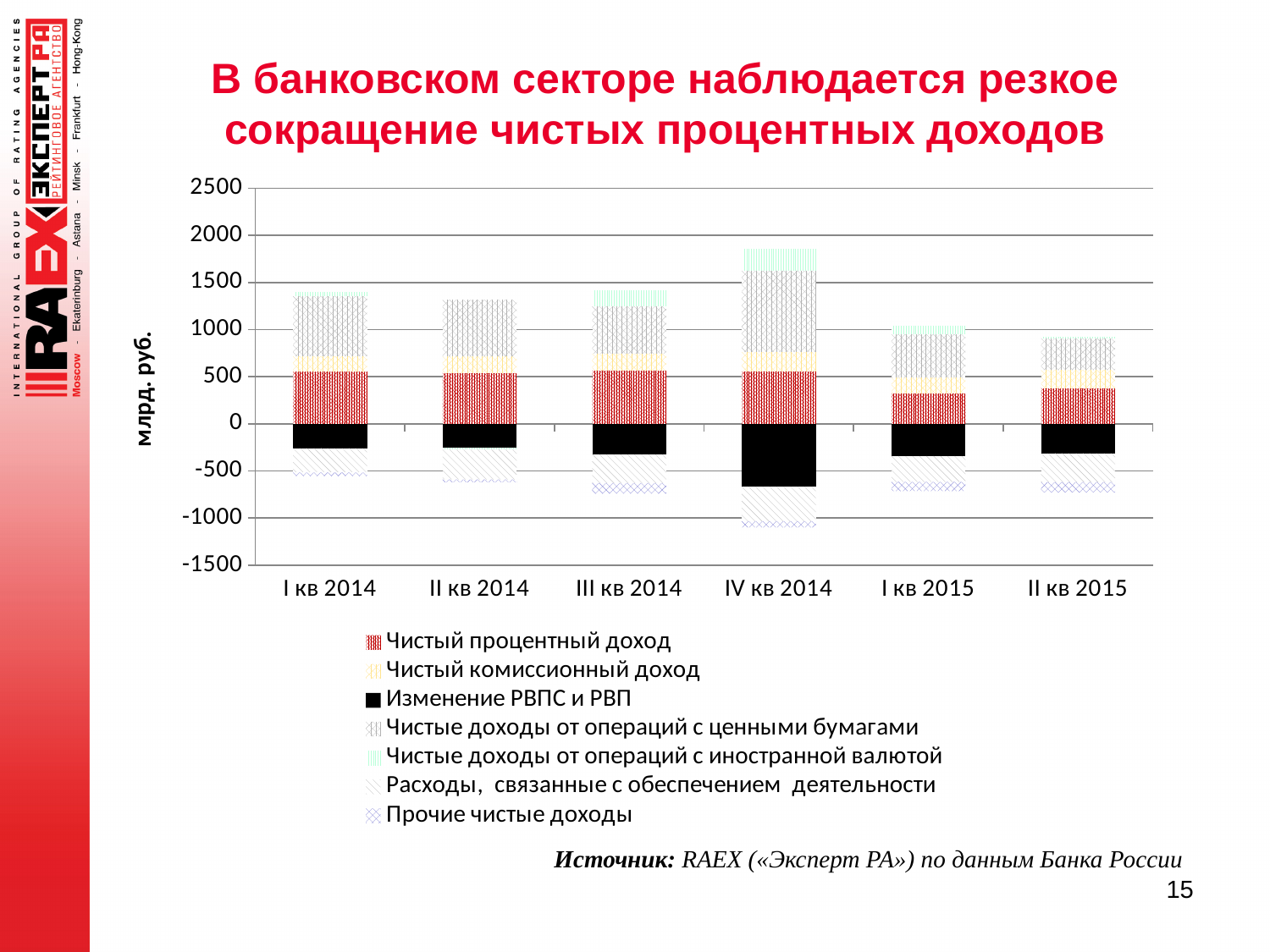
Is the total positive stack for II кв 2015 greater or less than 1000? less What kind of chart is shown on the slide? Stacked bar chart Is the total positive stack for IV кв 2014 greater or less than 1500? greater How many series does the chart legend list? 7 Which quarter has the largest negative value for 'Изменение РВПС и РВП'? IV кв 2014 Which quarter has the tallest positive stacked bar? IV кв 2014 Is the value of 'Чистый процентный доход' for II кв 2015 greater or less than 500? less What is the unit shown on the vertical axis of the chart? млрд. руб. How many quarters (categories) are shown on the x axis of the chart? 6 What is the title of the slide containing the chart? В банковском секторе наблюдается резкое сокращение чистых процентных доходов Which is larger, 'Чистый процентный доход' in I кв 2014 or in II кв 2015? I кв 2014 Does 'Чистый процентный доход' rise or fall from the 2014 quarters to the 2015 quarters? Fall